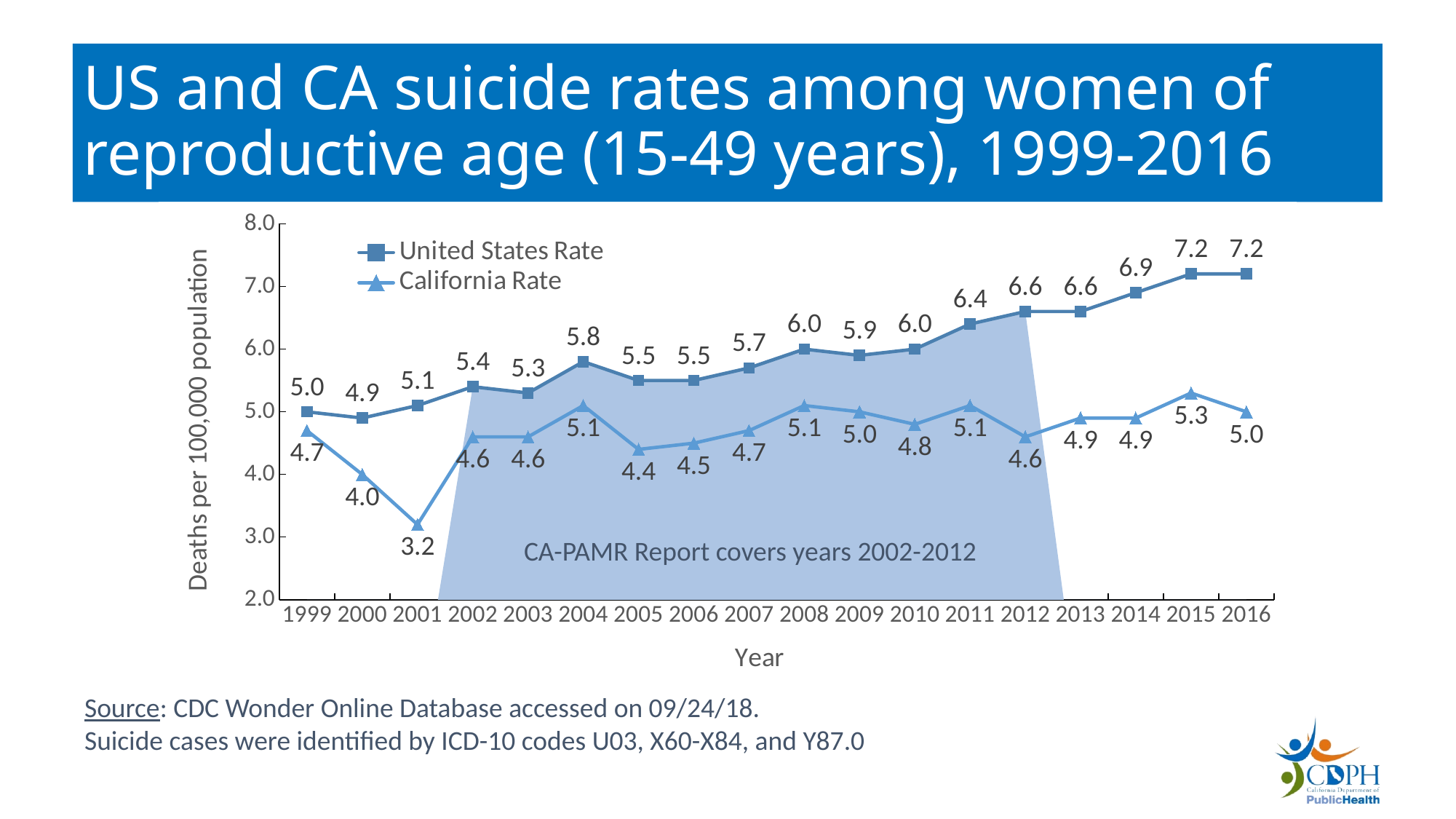
How many years are shown on the x axis? 18 In which year was the California rate lowest? 2001 What is the difference between the United States rate and the California rate in 2016? 2.2 What kind of chart is shown on the slide? Line chart What was the United States rate in 2008? 6.0 Does the United States rate generally rise or fall from 1999 to 2016? Rise What was the California rate in 2001? 3.2 Which years does the shaded area labelled CA-PAMR Report cover? 2002-2012 What is the highest United States rate shown on the chart? 7.2 How many series does the legend list? 2 What was the California rate in 2015? 5.3 Which was higher in 2004, the United States rate or the California rate? United States Rate